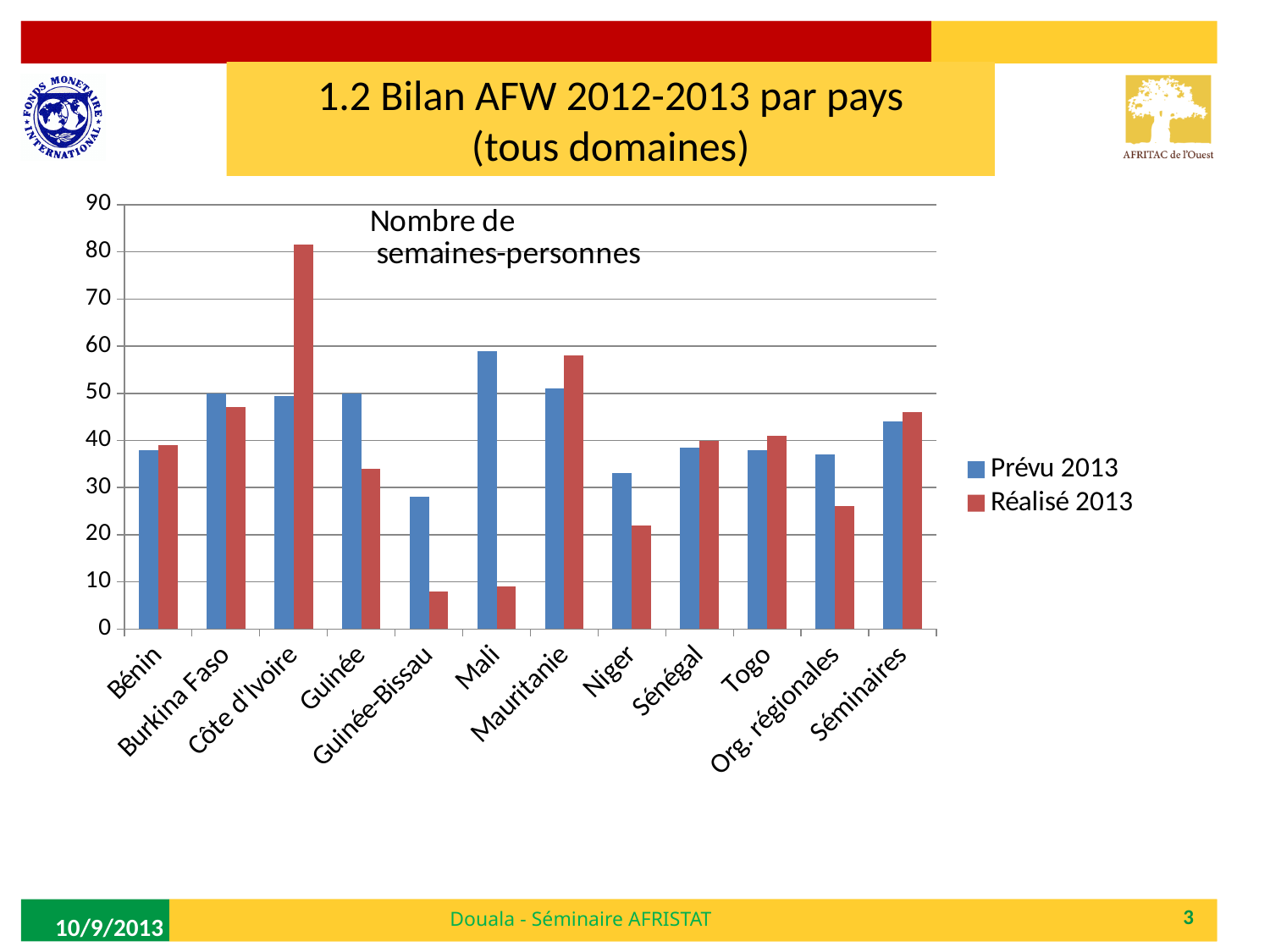
Which category has the lowest Prévu 2013 value? Guinée-Bissau How many series does the chart legend list? 2 For Guinée, which is larger: the Prévu 2013 value or the Réalisé 2013 value? Prévu 2013 Which category has the highest Réalisé 2013 value? Côte d'Ivoire How many categories are shown along the x axis of the chart? 12 What kind of chart is shown on the slide? bar chart Which category has the highest Prévu 2013 value? Mali Is the Réalisé 2013 value for Côte d'Ivoire greater or less than 70? greater Is the Prévu 2013 value for Mali greater or less than 50? greater Is the Réalisé 2013 value for Mali greater or less than 20? less What is the title shown inside the chart area? Nombre de semaines-personnes For Côte d'Ivoire, which is larger: the Prévu 2013 value or the Réalisé 2013 value? Réalisé 2013